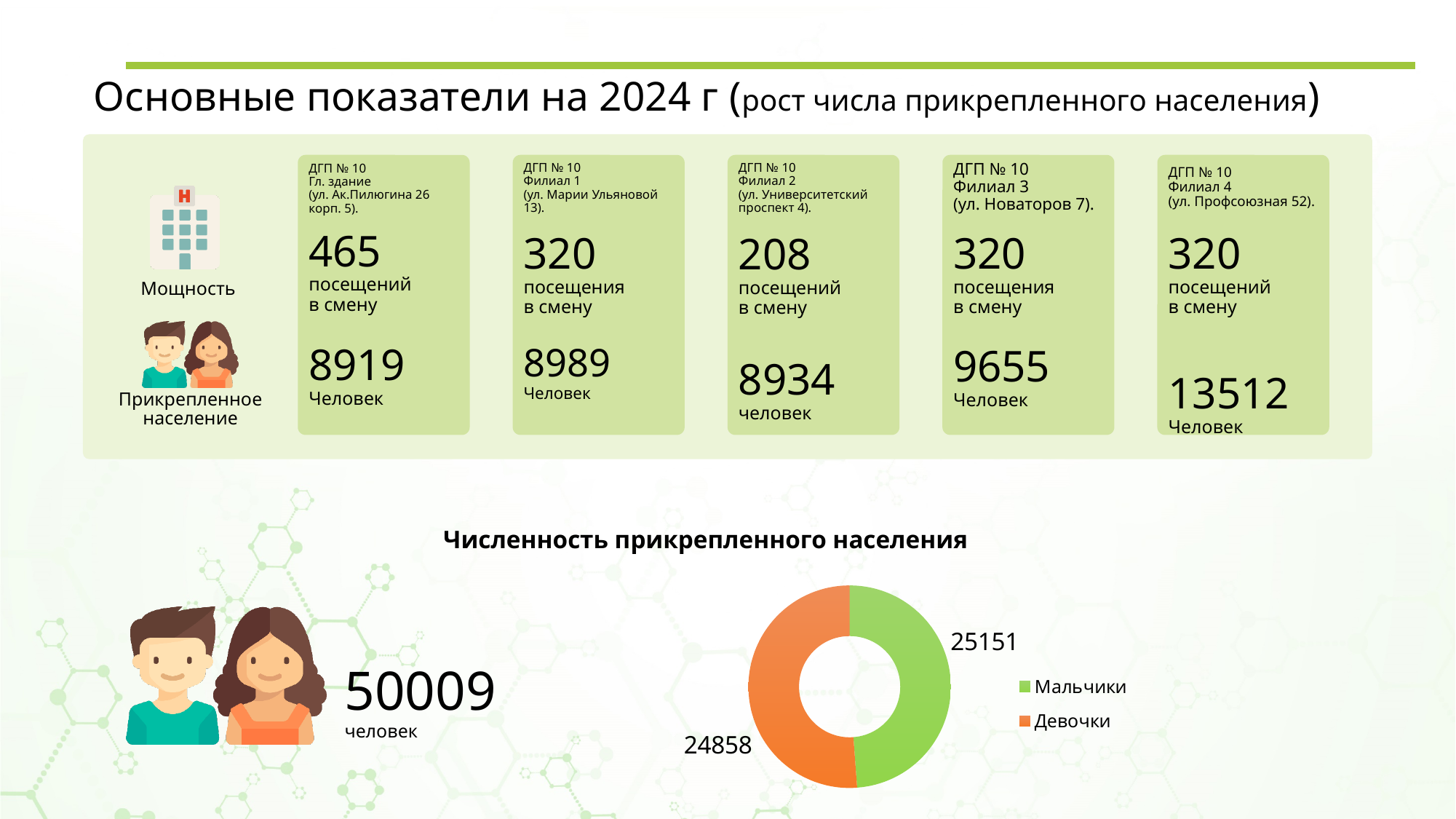
In the 'Численность прикрепленного населения' chart, what is the value for Девочки? 24858 What kind of chart is shown under the title 'Численность прикрепленного населения'? pie chart (doughnut) In the 'Численность прикрепленного населения' chart, what colour represents Девочки? orange In the 'Численность прикрепленного населения' chart, what colour represents Мальчики? green What is the total of the two slices in the 'Численность прикрепленного населения' chart? 50009 In the 'Численность прикрепленного населения' chart, which category has the smaller value? Девочки How many entries does the legend of the 'Численность прикрепленного населения' chart list? 2 How many categories does the 'Численность прикрепленного населения' chart show? 2 In the 'Численность прикрепленного населения' chart, which category has the larger value? Мальчики In the 'Численность прикрепленного населения' chart, what is the value for Мальчики? 25151 In the 'Численность прикрепленного населения' chart, is the value for Мальчики larger or smaller than the value for Девочки? larger In the 'Численность прикрепленного населения' chart, what is the difference between the values for Мальчики and Девочки? 293